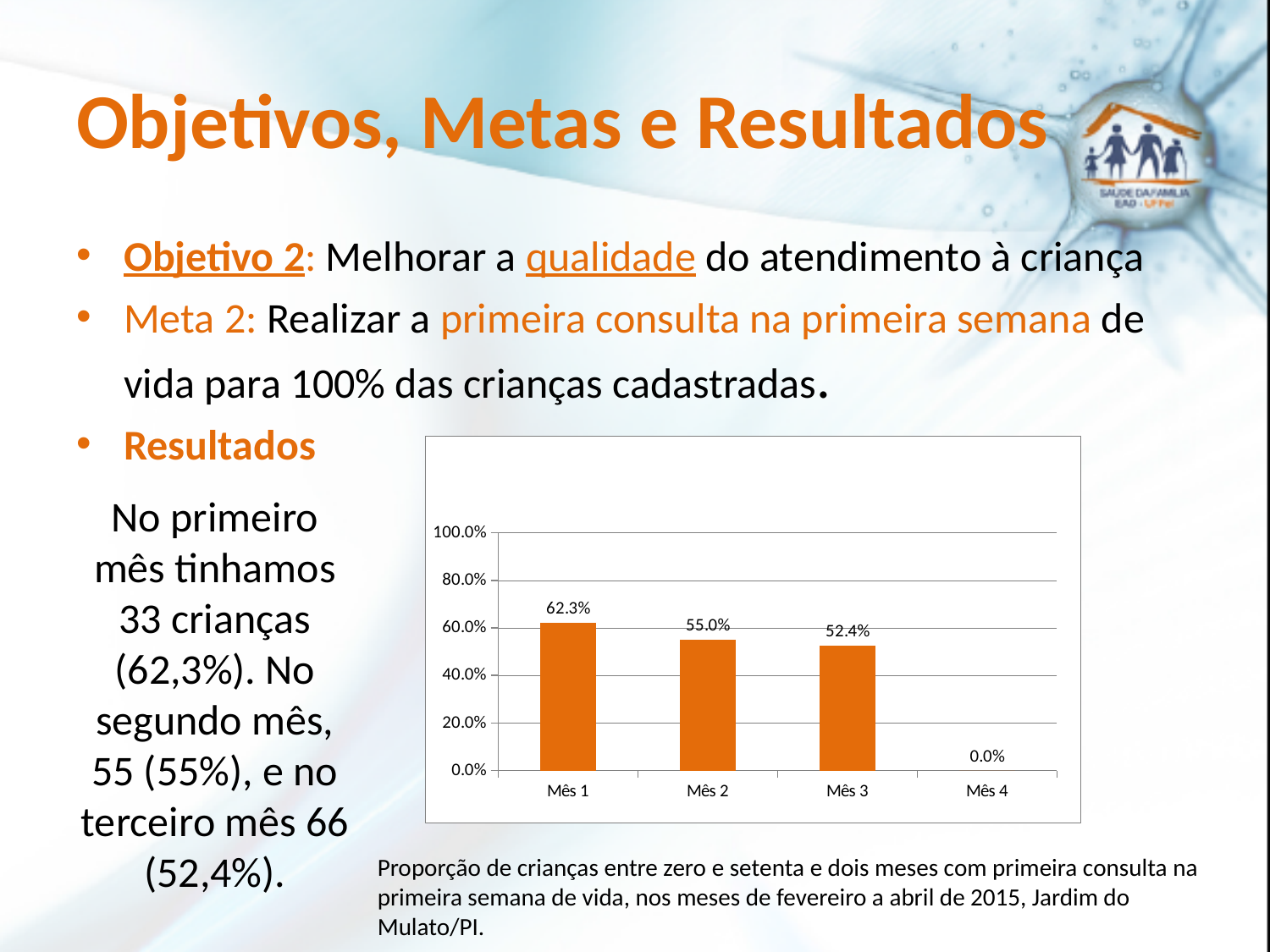
How many months are shown on the x axis of the chart? 4 Which month has the highest value? Mês 1 What is the value for Mês 1? 62.3% What is the value for Mês 4? 0.0% What is the value for Mês 3? 52.4% Which is larger, the value for Mês 1 or the value for Mês 3? Mês 1 What is the value for Mês 2? 55.0% Do the values rise or fall from Mês 1 to Mês 4? Fall What kind of chart is shown on the slide? Bar chart What is the difference between the values for Mês 1 and Mês 2? 7.3% Which month has the lowest value? Mês 4 What is the difference between the values for Mês 2 and Mês 3? 2.6%